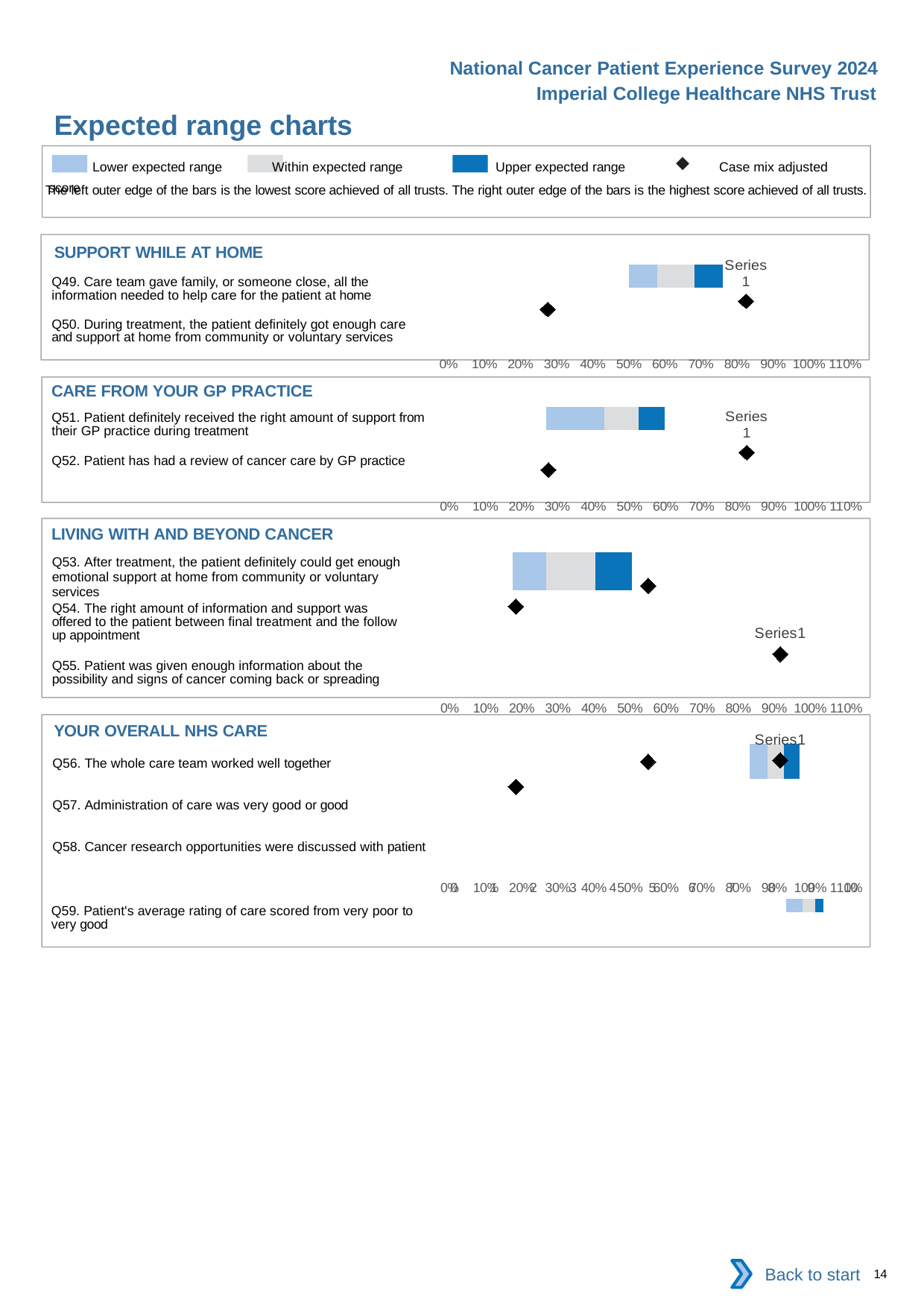
How many entries does the legend at the top of the slide list? 4 How many section charts are shown on the slide? 4 How many diamond markers are plotted in the "LIVING WITH AND BEYOND CANCER" chart? 3 What kind of chart is used in the "SUPPORT WHILE AT HOME" section? bar chart In the "SUPPORT WHILE AT HOME" chart, is the leftmost diamond greater or less than 40%? less In the "CARE FROM YOUR GP PRACTICE" chart, is the diamond labelled "Series 1" greater or less than 70%? greater In the "SUPPORT WHILE AT HOME" chart, is the diamond labelled "Series 1" greater or less than 70%? greater According to the legend, which colour represents the upper expected range? dark blue What is the highest percentage tick shown on the x axis of the "CARE FROM YOUR GP PRACTICE" chart? 110%